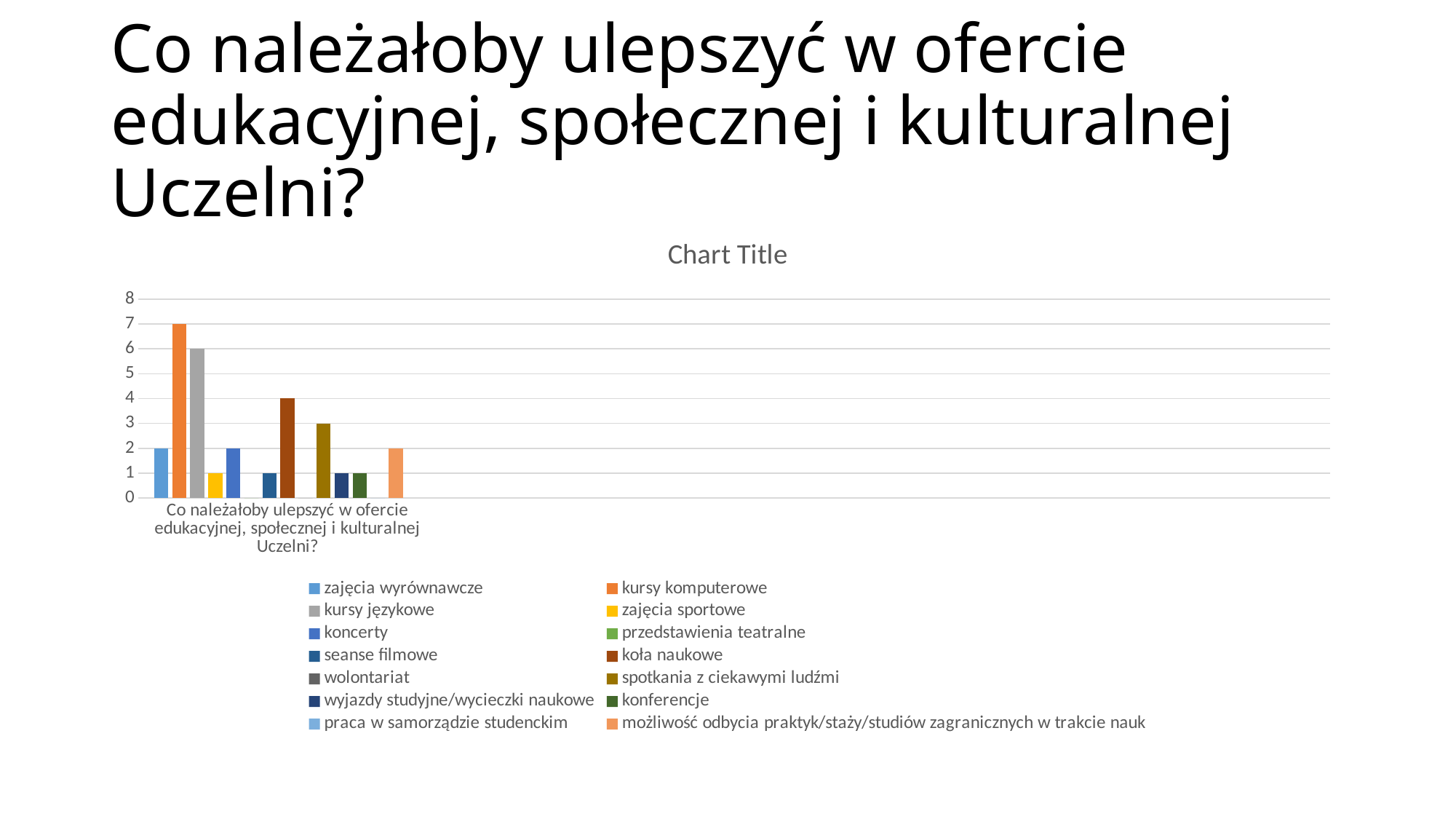
What is the value for spotkania z ciekawymi ludźmi? 3 What is the value for koła naukowe? 4 What is the value for kursy językowe? 6 What is the value for kursy komputerowe? 7 How many series does the legend list? 14 Is the value for kursy komputerowe greater or less than 5? greater What is the difference between the values for kursy komputerowe and kursy językowe? 1 Which is larger, the value for koła naukowe or the value for spotkania z ciekawymi ludźmi? koła naukowe What kind of chart is shown on the slide? bar chart Which series has the highest bar? kursy komputerowe What colour is the bar for kursy językowe? gray What is the title shown above the chart? Chart Title